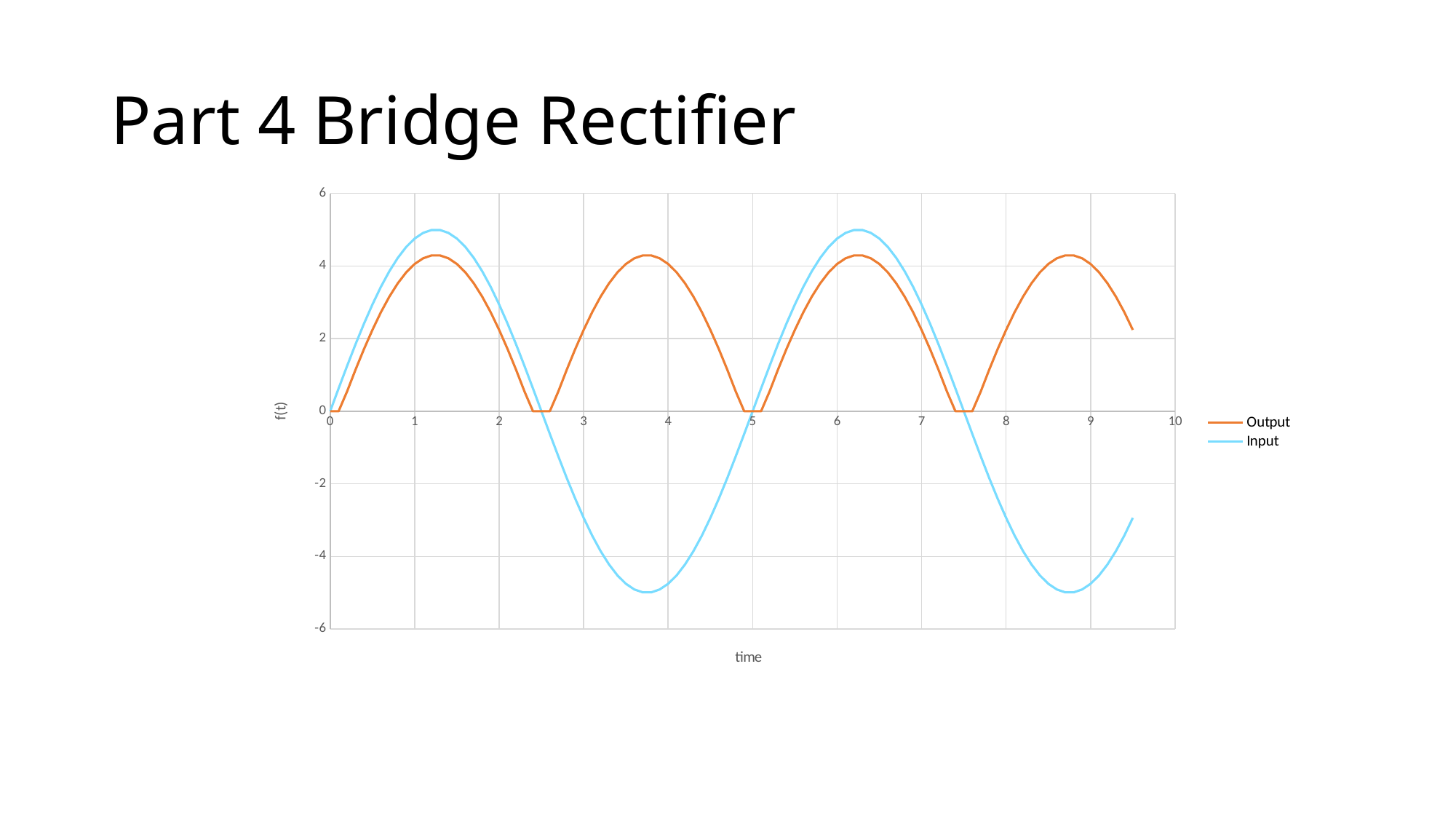
Is the peak value of the Output series greater or less than 2? greater What is the title of the x axis? time What is the value of the Input series at time 0? 0 How many series does the legend list? 2 What kind of chart is shown on the slide? line chart Which series reaches the higher maximum value, Output or Input? Input What are the two series named in the legend? Output and Input Is the peak value of the Input series greater or less than 4? greater Which series reaches the lower minimum value, Output or Input? Input Is the minimum value of the Output series greater or less than -2? greater Between time 2 and time 3, does the Input series rise or fall? fall